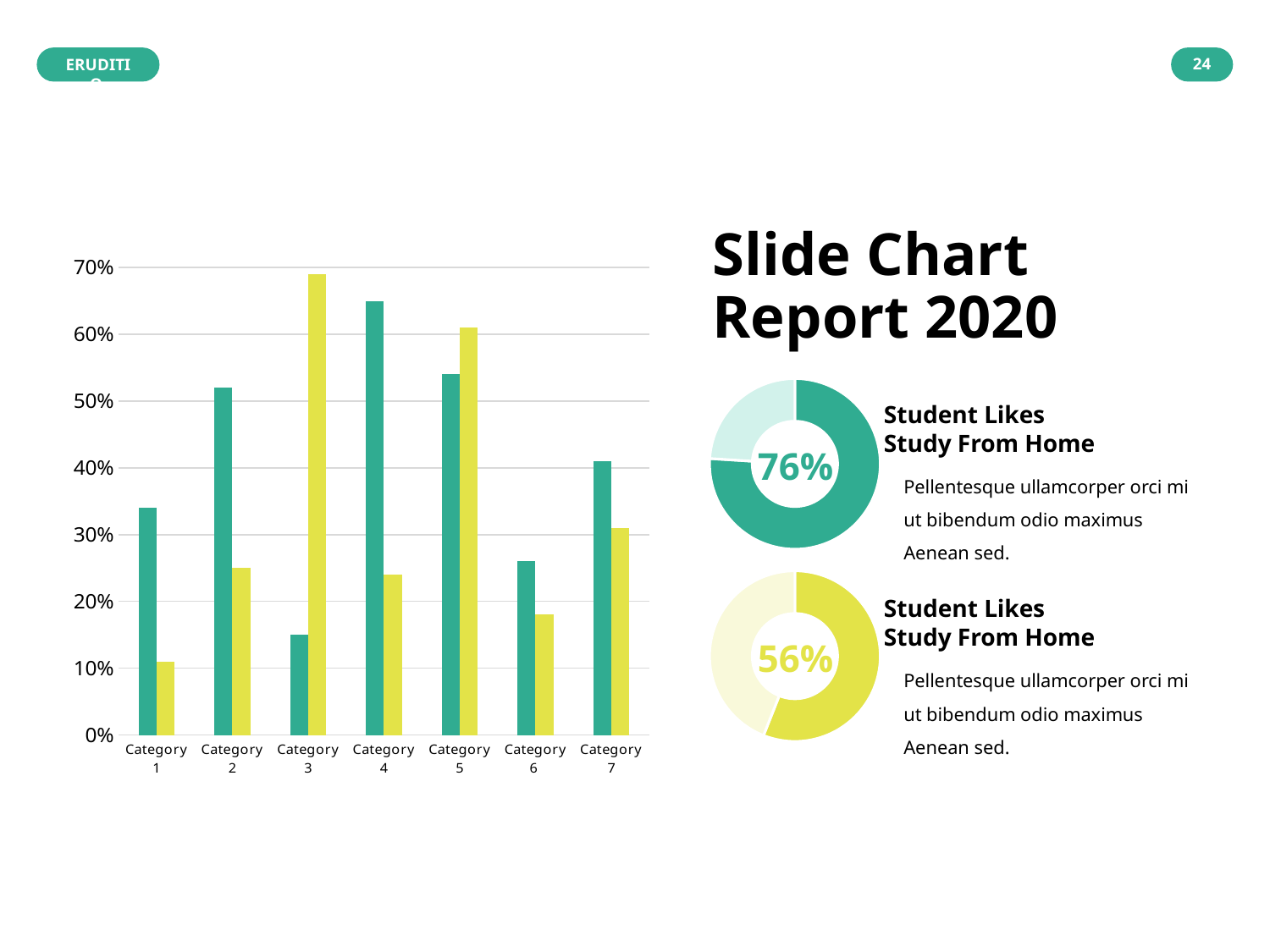
In the bar chart on the left, is the green bar for Category 1 greater or less than 30%? greater What percentage is shown in the centre of the upper (green) donut chart on the right? 76% In the bar chart on the left, for Category 7, which bar is taller, the green one or the yellow one? the green one What percentage is shown in the centre of the lower (yellow) donut chart on the right? 56% In the bar chart on the left, which category has the shortest yellow bar? Category 1 In the bar chart on the left, how many categories are shown on the x axis? 7 In the bar chart on the left, for Category 5, which bar is taller, the green one or the yellow one? the yellow one In the bar chart on the left, which category has the tallest green bar? Category 4 In the bar chart on the left, which category has the shortest green bar? Category 3 What kind of chart is the large chart on the left of the slide? bar chart In the bar chart on the left, which category has the tallest yellow bar? Category 3 In the bar chart on the left, is the yellow bar for Category 4 greater or less than 30%? less